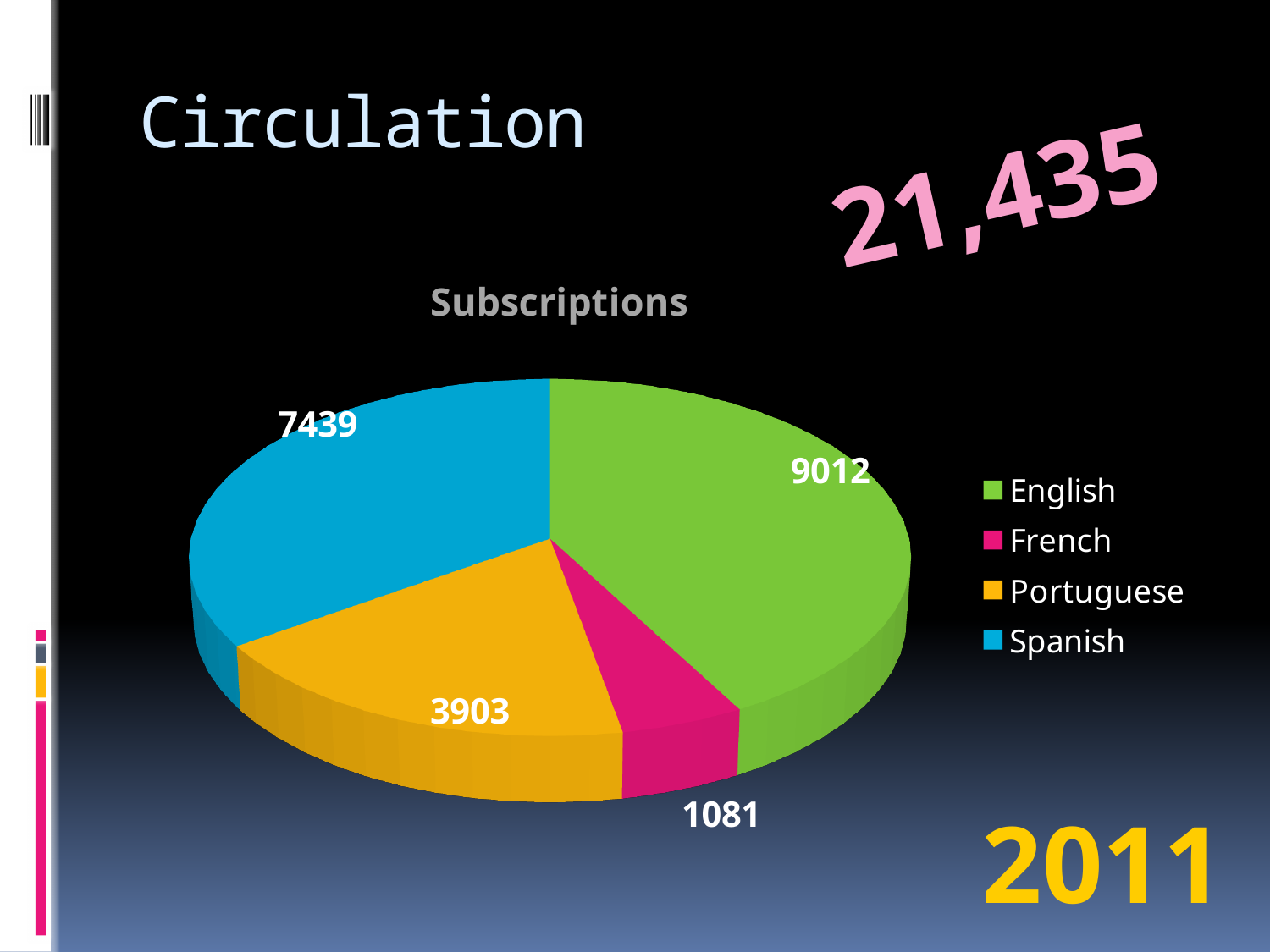
Which has more subscriptions, Portuguese or Spanish? Spanish How many languages are listed in the legend? 4 Which language has the smallest number of subscriptions? French Which language has the largest number of subscriptions? English How many subscriptions are shown for Spanish? 7439 How many subscriptions are shown for French? 1081 How many subscriptions are shown for English? 9012 What is the difference between the English and Spanish subscription counts? 1573 What type of chart is shown on the slide? pie chart What is the title of the chart? Subscriptions What colour represents Portuguese in the pie chart? orange How many subscriptions are shown for Portuguese? 3903